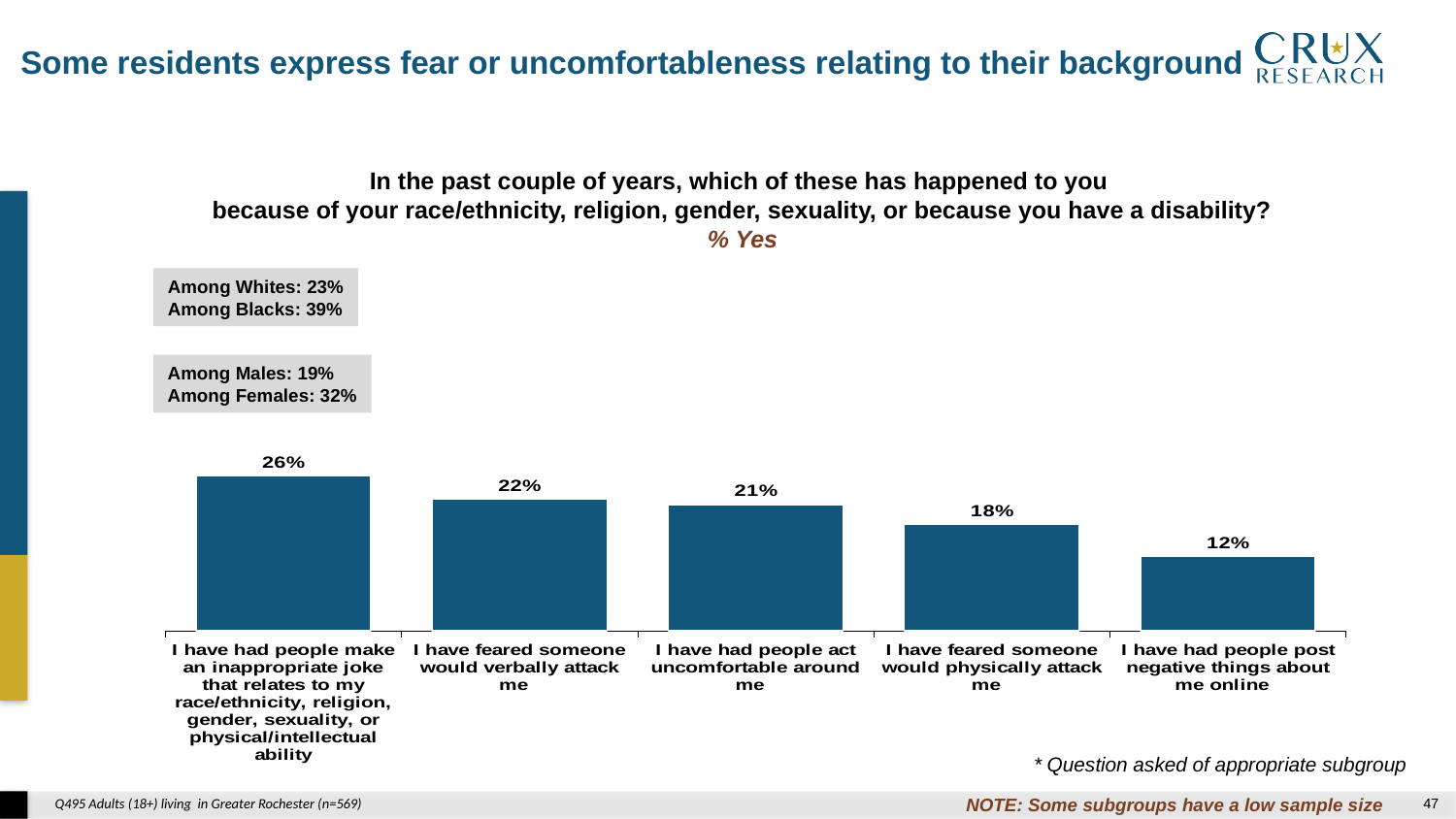
How many experience categories are shown in the chart? 5 What is the difference in % Yes between 'I have had people make an inappropriate joke...' and 'I have had people post negative things about me online'? 14 percentage points Which experience has the highest % Yes in the chart? I have had people make an inappropriate joke that relates to my race/ethnicity, religion, gender, sexuality, or physical/intellectual ability Which is larger: the % Yes for 'I have had people act uncomfortable around me' or for 'I have feared someone would physically attack me'? I have had people act uncomfortable around me Do the values rise or fall moving from left to right across the chart? Fall What percentage of respondents said they have had people make an inappropriate joke that relates to their race/ethnicity, religion, gender, sexuality, or physical/intellectual ability? 26% What type of chart is shown on the slide? Bar chart What percentage of respondents said they have had people post negative things about them online? 12% According to the callout box, what is the % Yes among Females? 32% What percentage of respondents said they have feared someone would physically attack them? 18% What percentage of respondents said they have feared someone would verbally attack them? 22% Which experience has the lowest % Yes in the chart? I have had people post negative things about me online